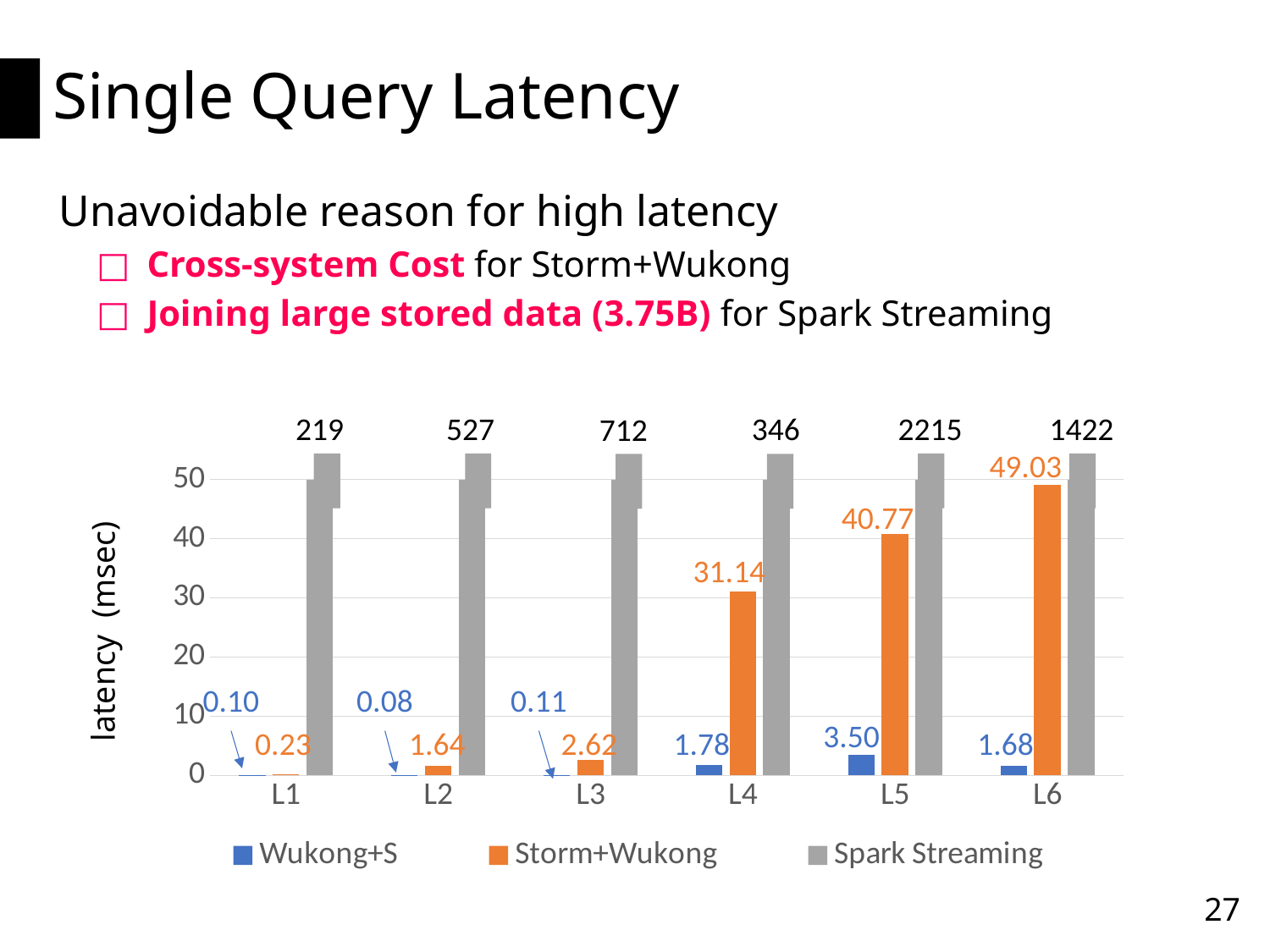
What is the label of the y axis? latency (msec) What is the Storm+Wukong latency for L5? 40.77 What is the difference between the Storm+Wukong latency for L6 and for L5? 8.26 Which query has the highest Spark Streaming latency? L5 What is the Spark Streaming latency for L3? 712 Which query has the lowest Wukong+S latency? L2 What is the Wukong+S latency for L4? 1.78 How many series does the legend list? 3 Which is larger, the Spark Streaming latency for L2 or for L4? L2 Which query has the highest Storm+Wukong latency? L6 What kind of chart is shown on the slide? bar chart How many queries (categories) are shown on the x axis? 6